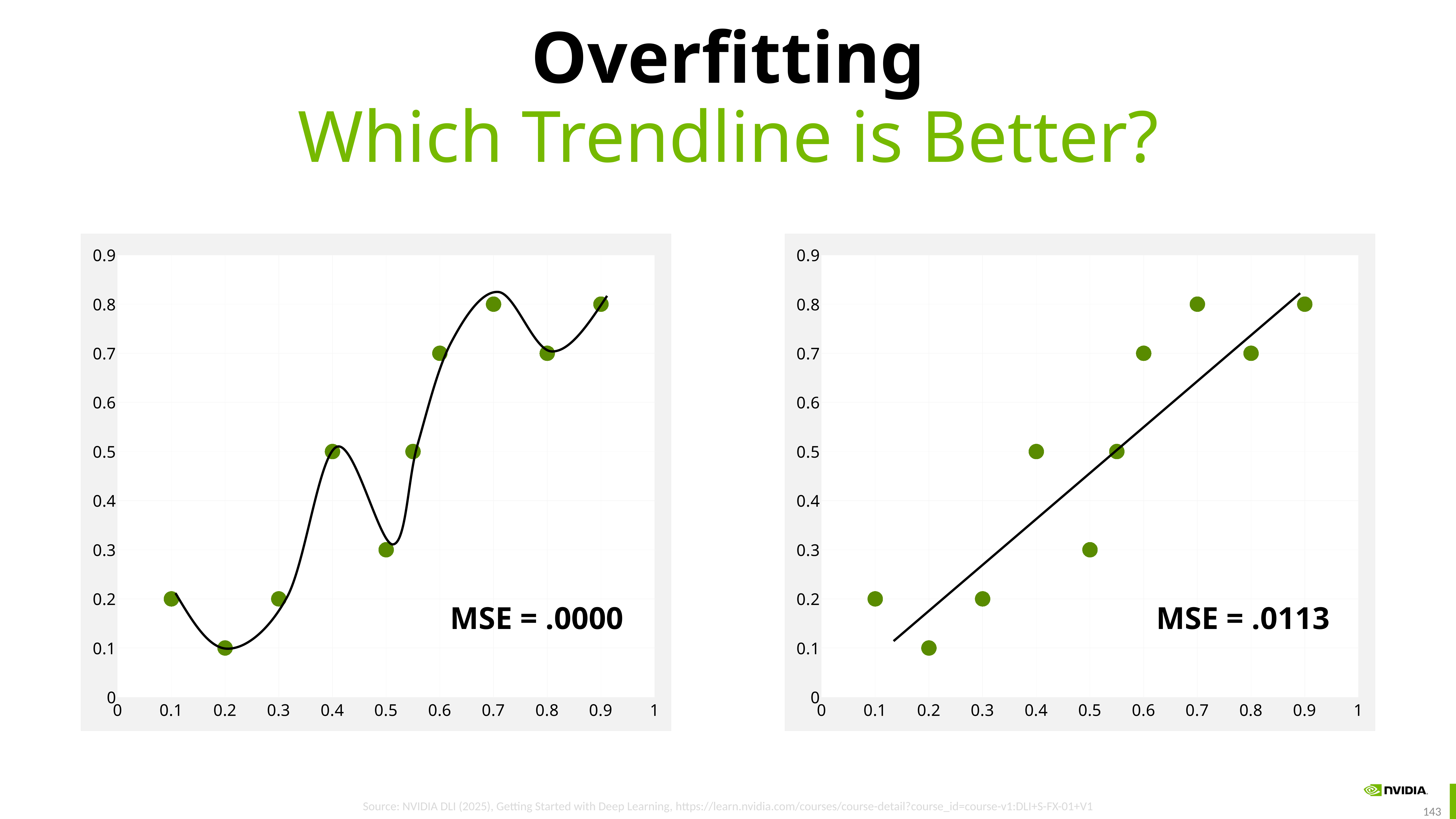
On the left chart, what is the y value of the point at x = 0.2? 0.1 What is the shape of the trendline on the right chart, a straight line or a wavy curve? straight line On the right chart, do the plotted points generally rise or fall as x increases? rise What MSE value is printed on the right chart? MSE = .0113 On the right chart, what is the lowest y value among the plotted points? 0.1 What kind of chart is the left chart? scatter chart On the right chart, what is the y value of the point at x = 0.5? 0.3 Which chart has the higher printed MSE, the left chart or the right chart? right chart On the left chart, what is the highest y value among the plotted points? 0.8 On the right chart, is the y value of the point at x = 0.7 greater or less than 0.5? greater What MSE value is printed on the left chart? MSE = .0000 How many data points are plotted on the right chart? 10